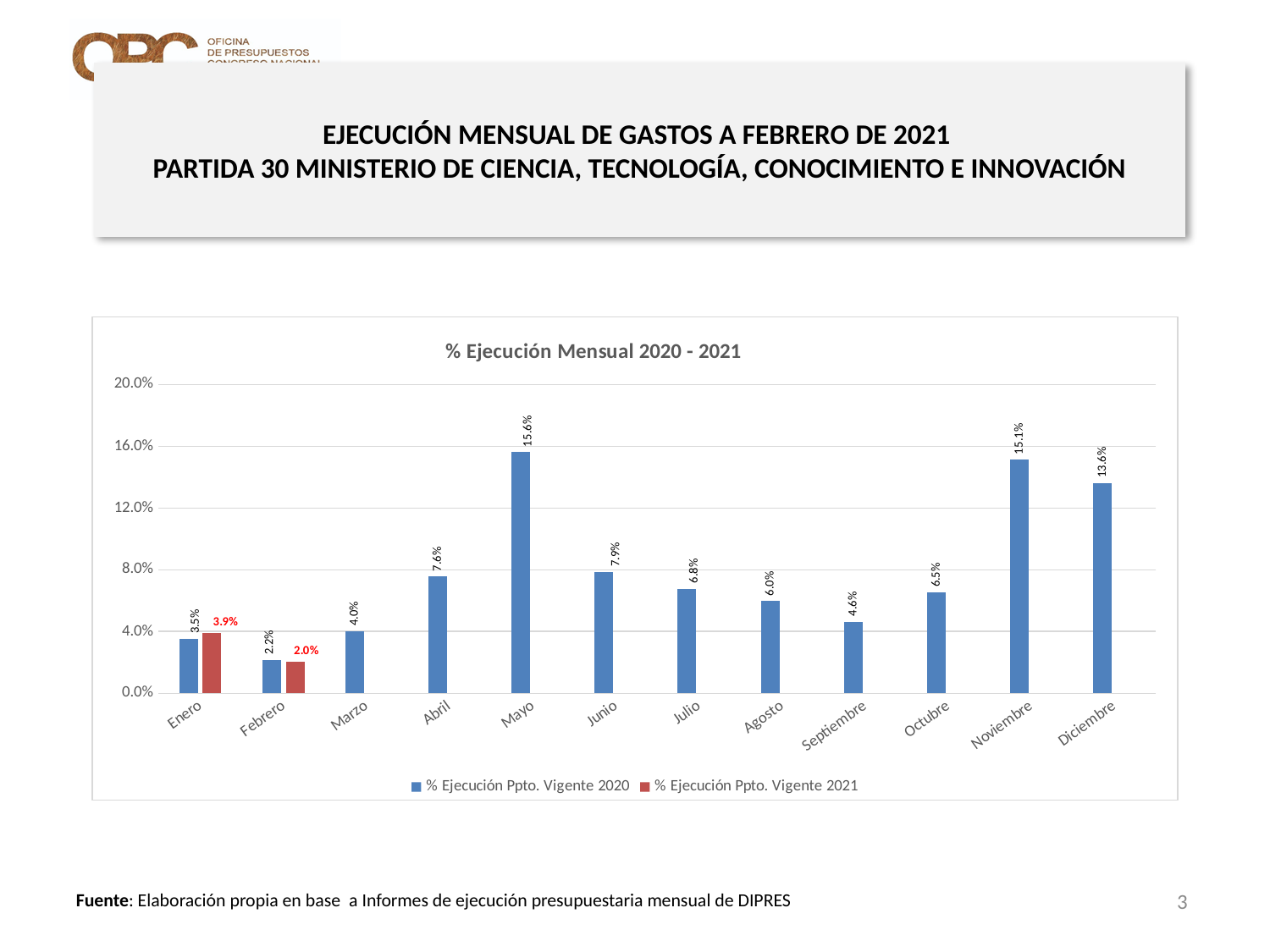
What is the value for Mayo in the % Ejecución Ppto. Vigente 2020 series? 15.6% How many months are shown on the x axis? 12 Which month has the highest value in the % Ejecución Ppto. Vigente 2020 series? Mayo What is the title of the chart? % Ejecución Mensual 2020 - 2021 Which month has the lowest value in the % Ejecución Ppto. Vigente 2020 series? Febrero What is the value for Febrero in the % Ejecución Ppto. Vigente 2021 series? 2.0% Which is larger for Febrero: the 2020 value or the 2021 value? 2020 value What kind of chart is shown? Bar chart How many series does the legend list? 2 What is the value for Noviembre in the % Ejecución Ppto. Vigente 2020 series? 15.1% What is the difference between the 2021 and 2020 values for Enero? 0.4% Is the value for Diciembre in the 2020 series greater or less than 12.0%? greater